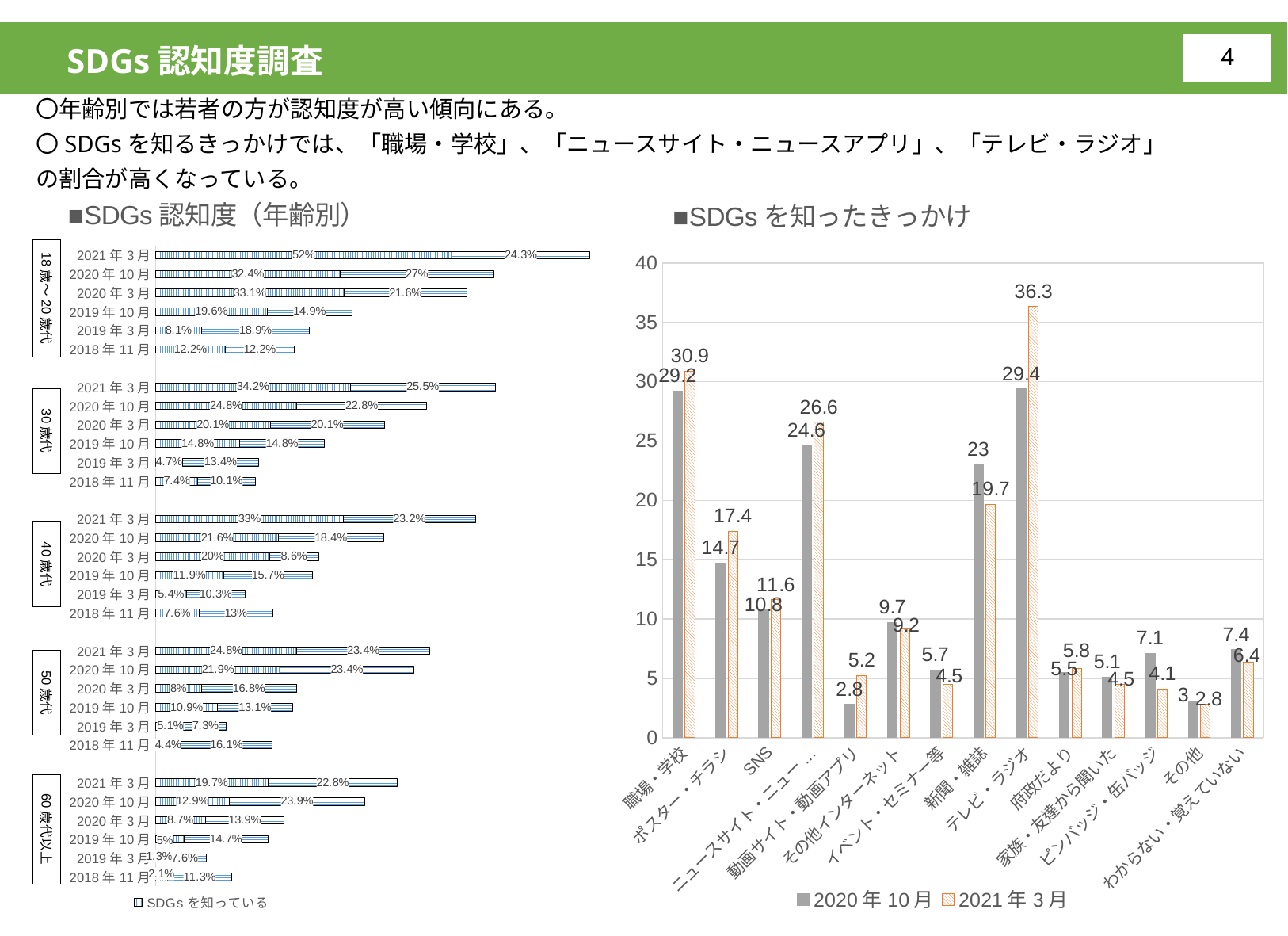
In the chart titled 「SDGsを知ったきっかけ」, how many series does the legend list? 2 In the chart titled 「SDGsを知ったきっかけ」, what is the difference between the 2021年3月 and 2020年10月 values for テレビ・ラジオ? 6.9 In the chart titled 「SDGsを知ったきっかけ」, which category has the lowest value in the 2020年10月 series? 動画サイト・動画アプリ In the chart titled 「SDGs認知度（年齢別）」, what is the first value shown for 2021年3月 in the 30歳代 group? 34.2% In the chart titled 「SDGsを知ったきっかけ」, which category has the highest value in the 2021年3月 series? テレビ・ラジオ What kind of chart is the chart titled 「SDGsを知ったきっかけ」? bar chart In the chart titled 「SDGs認知度（年齢別）」, what is the first value shown for 2021年3月 in the 18歳～20歳代 group? 52% In the chart titled 「SDGsを知ったきっかけ」, what is the value for 職場・学校 in the 2020年10月 series? 29.2 In the chart titled 「SDGsを知ったきっかけ」, what is the value for テレビ・ラジオ in the 2021年3月 series? 36.3 In the chart titled 「SDGsを知ったきっかけ」, which is larger for 新聞・雑誌: the 2020年10月 value or the 2021年3月 value? 2020年10月 In the chart titled 「SDGsを知ったきっかけ」, what is the value for 新聞・雑誌 in the 2021年3月 series? 19.7 In the chart titled 「SDGsを知ったきっかけ」, how many categories are shown on the x axis? 14